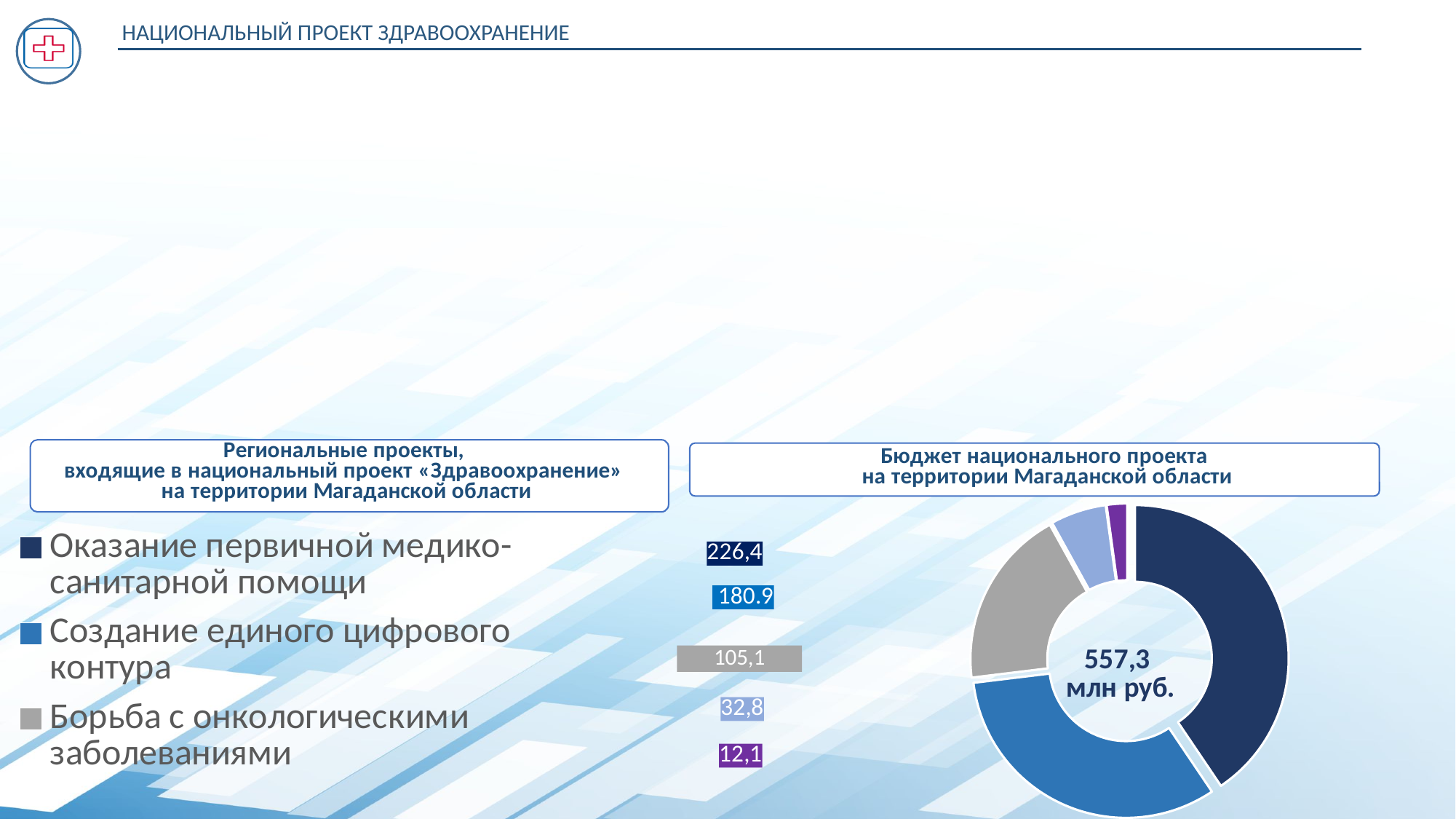
What colour represents «Борьба с онкологическими заболеваниями» in the chart? Gray What is the value for «Оказание первичной медико-санитарной помощи»? 226,4 Which is larger: the value for «Оказание первичной медико-санитарной помощи» or for «Борьба с онкологическими заболеваниями»? Оказание первичной медико-санитарной помощи What is the difference between the values for «Оказание первичной медико-санитарной помощи» and «Борьба с онкологическими заболеваниями»? 121,3 Which category has the largest value in the chart? Оказание первичной медико-санитарной помощи What is the value for «Борьба с онкологическими заболеваниями»? 105,1 How many entries does the legend list? 3 What is the value for «Создание единого цифрового контура»? 180.9 What total is shown in the centre of the donut chart? 557,3 млн руб. How many slices does the donut chart have? 5 What is the smallest value shown on the chart? 12,1 What type of chart is shown on the slide? Pie (donut) chart